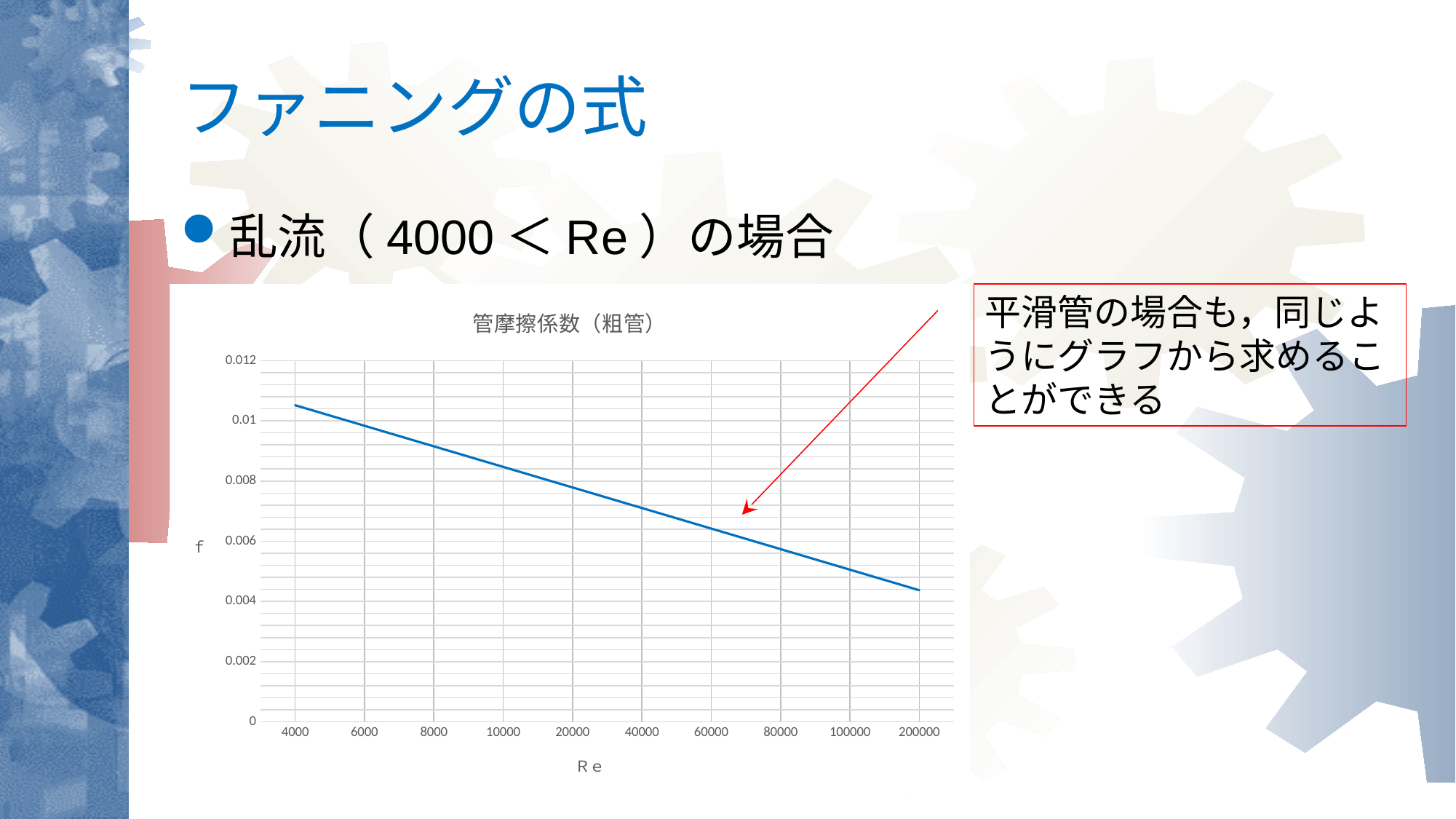
What kind of chart is shown on the slide? line chart Is the value of f at Re = 100000 greater or less than 0.006? less At which Re value on the x axis is f highest? 4000 How many Re values are labelled on the x axis of the chart? 10 Does the value of f rise or fall as Re increases along the x axis? fall Is the value of f at Re = 200000 greater or less than 0.006? less Which is larger, the value of f at Re = 6000 or at Re = 80000? Re = 6000 What is the label of the x axis of the chart? Re Is the value of f at Re = 4000 greater or less than 0.008? greater At which Re value on the x axis is f lowest? 200000 What is the title of the chart? 管摩擦係数（粗管）